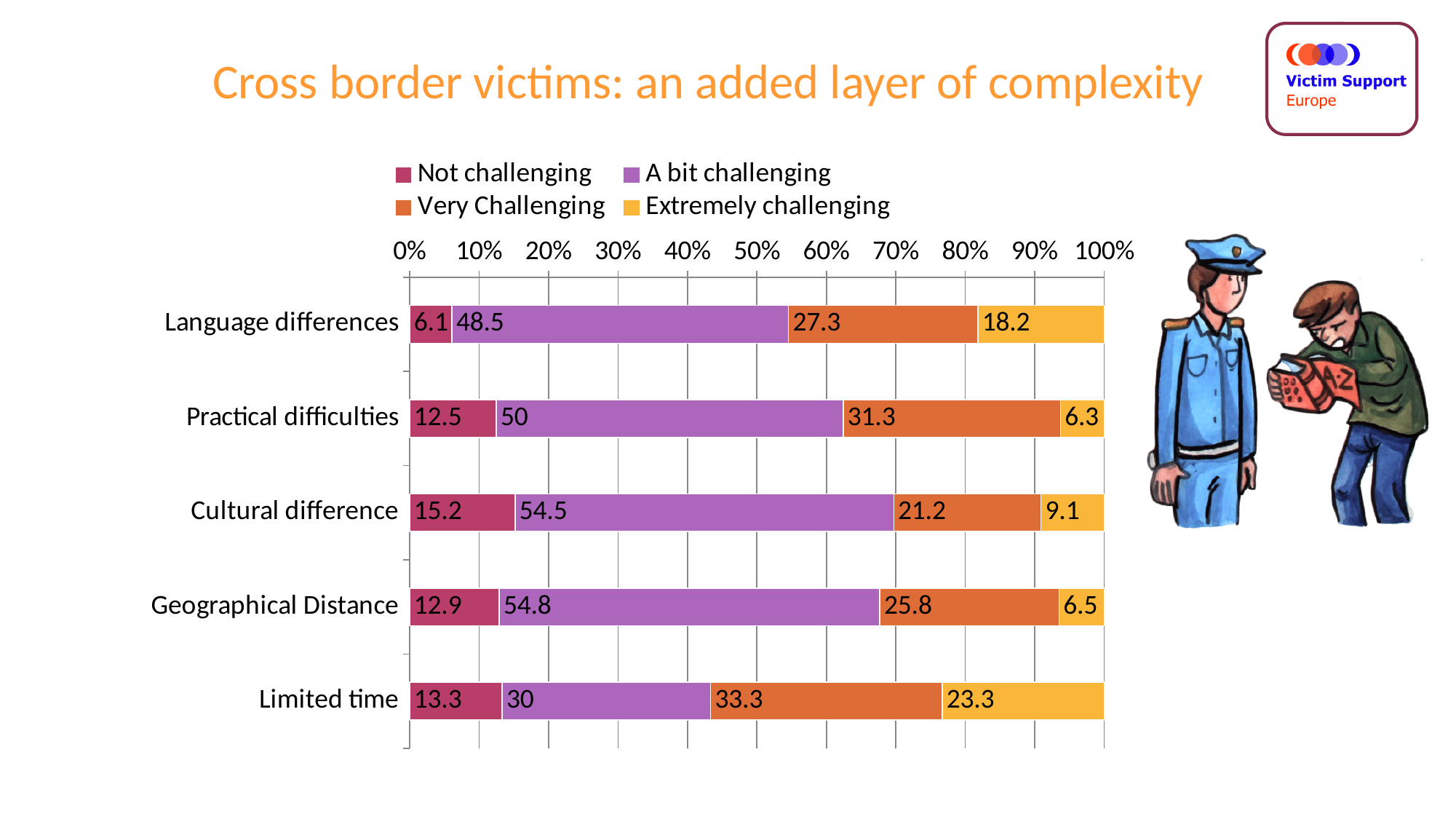
What is the difference between the "Very Challenging" values for Limited time and Cultural difference? 12.1 What kind of chart is shown on the slide? Stacked bar chart What is the value for "A bit challenging" for Practical difficulties? 50 What is the value for "Extremely challenging" for Language differences? 18.2 What is the value for "Very Challenging" for Limited time? 33.3 Which category has the highest value for "Extremely challenging"? Limited time What is the value for "Not challenging" for Geographical Distance? 12.9 How many series does the legend list? 4 Which category has the lowest value for "Not challenging"? Language differences Which is larger: the "A bit challenging" value for Geographical Distance or for Language differences? Geographical Distance How many categories are shown on the chart? 5 Which legend entry is shown in orange? Very Challenging